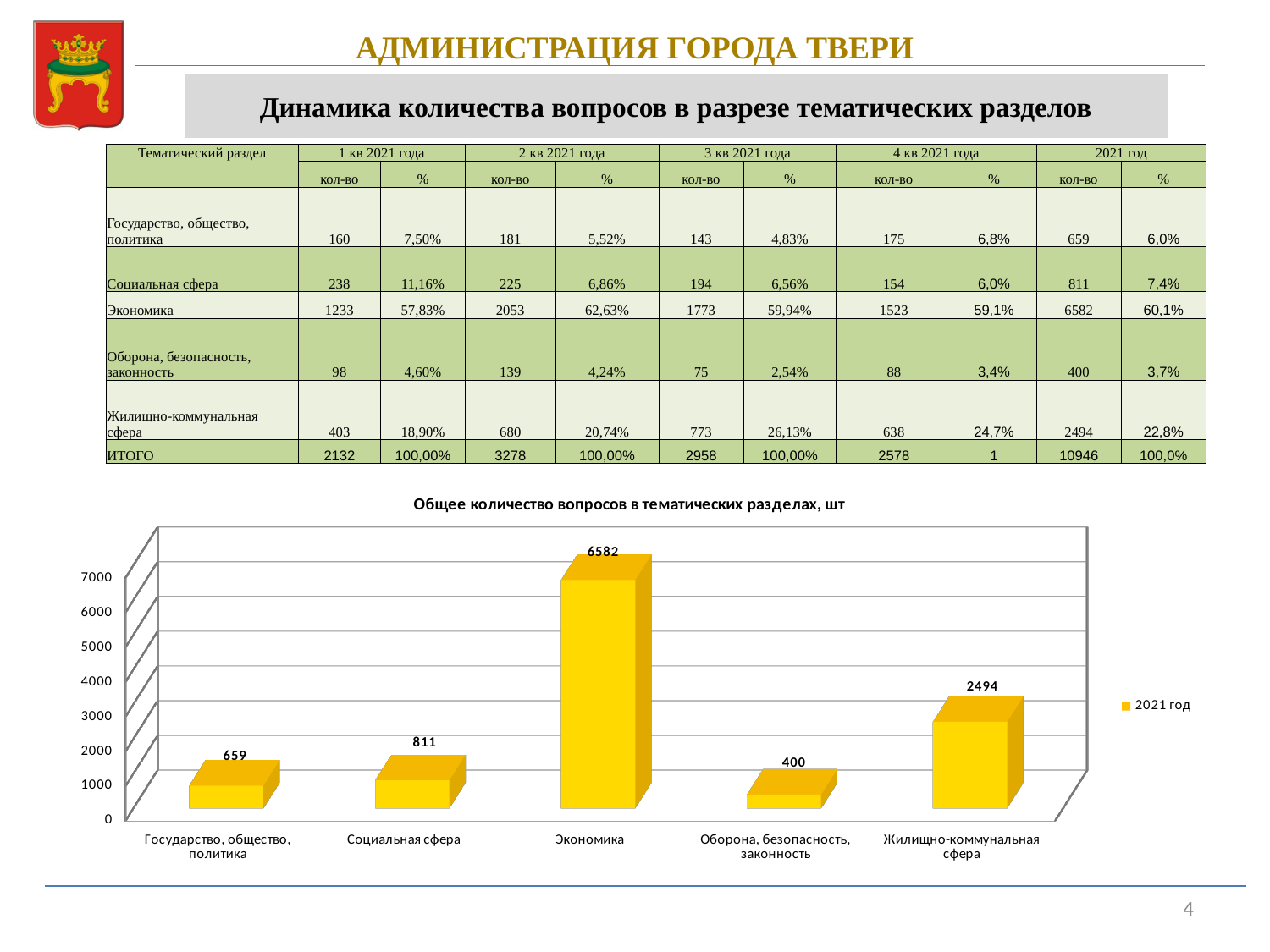
What is the title of the chart? Общее количество вопросов в тематических разделах, шт What is the value for Оборона, безопасность, законность in the chart? 400 What type of chart is shown on the slide? Bar chart What is the difference between the values for Экономика and Жилищно-коммунальная сфера? 4088 What is the value for Экономика in the chart? 6582 What is the value for Жилищно-коммунальная сфера in the chart? 2494 Which category has the lowest value in the chart? Оборона, безопасность, законность What is the difference between the values for Социальная сфера and Государство, общество, политика? 152 What is the value for Государство, общество, политика in the chart? 659 How many categories are shown in the chart? 5 Which is larger: the value for Социальная сфера or the value for Оборона, безопасность, законность? Социальная сфера Which category has the highest value in the chart? Экономика